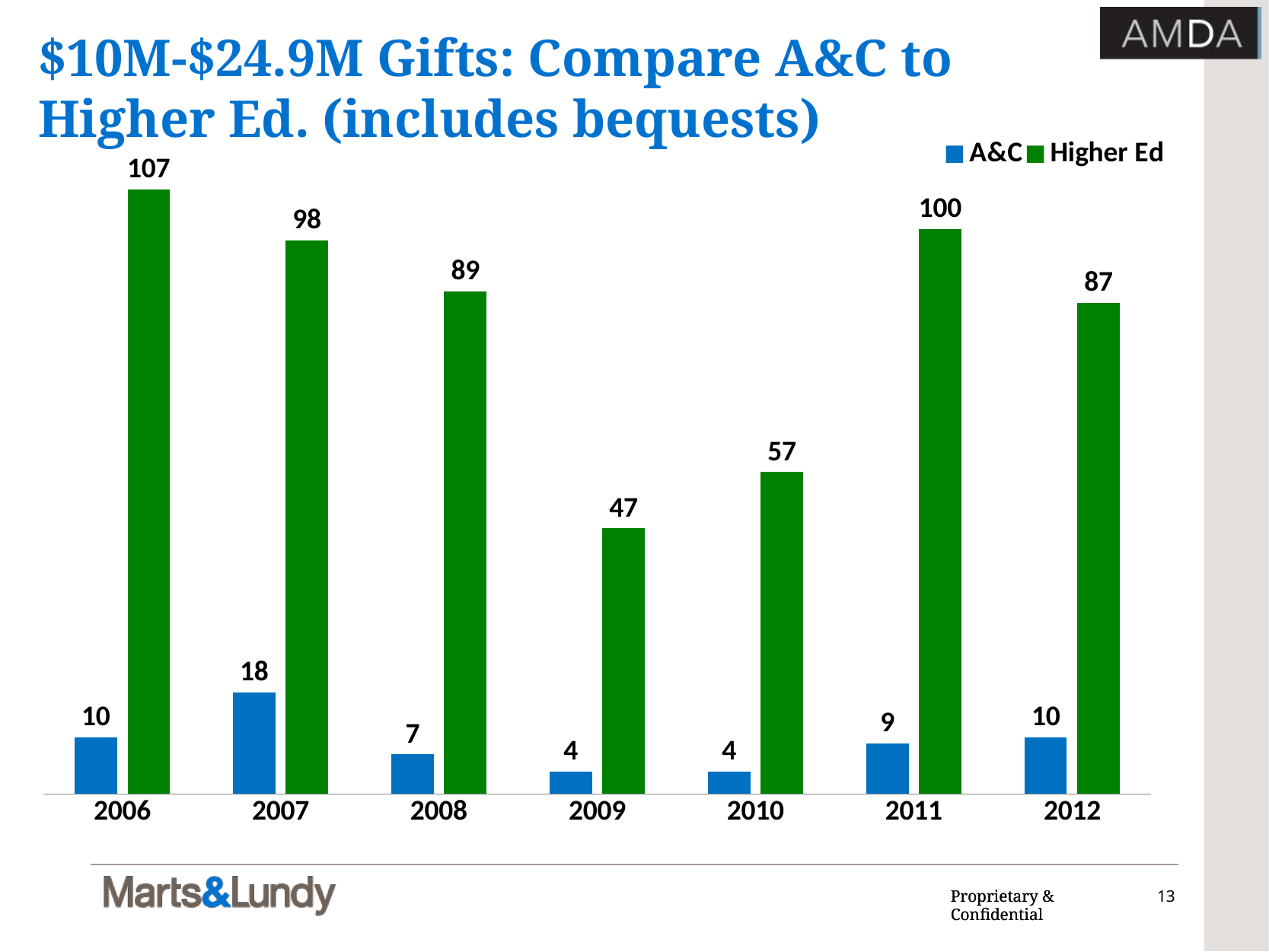
Which is larger, the Higher Ed value for 2008 or for 2012? 2008 Which colour represents Higher Ed in the chart? Green How many series does the legend list? 2 Which year has the lowest Higher Ed value? 2009 What is the A&C value for 2007? 18 What kind of chart is shown on the slide? Bar chart Which year has the highest Higher Ed value? 2006 What is the Higher Ed value for 2006? 107 How many years are shown on the x axis? 7 Which year has the highest A&C value? 2007 What is the Higher Ed value for 2010? 57 What is the difference between the Higher Ed and A&C values in 2011? 91